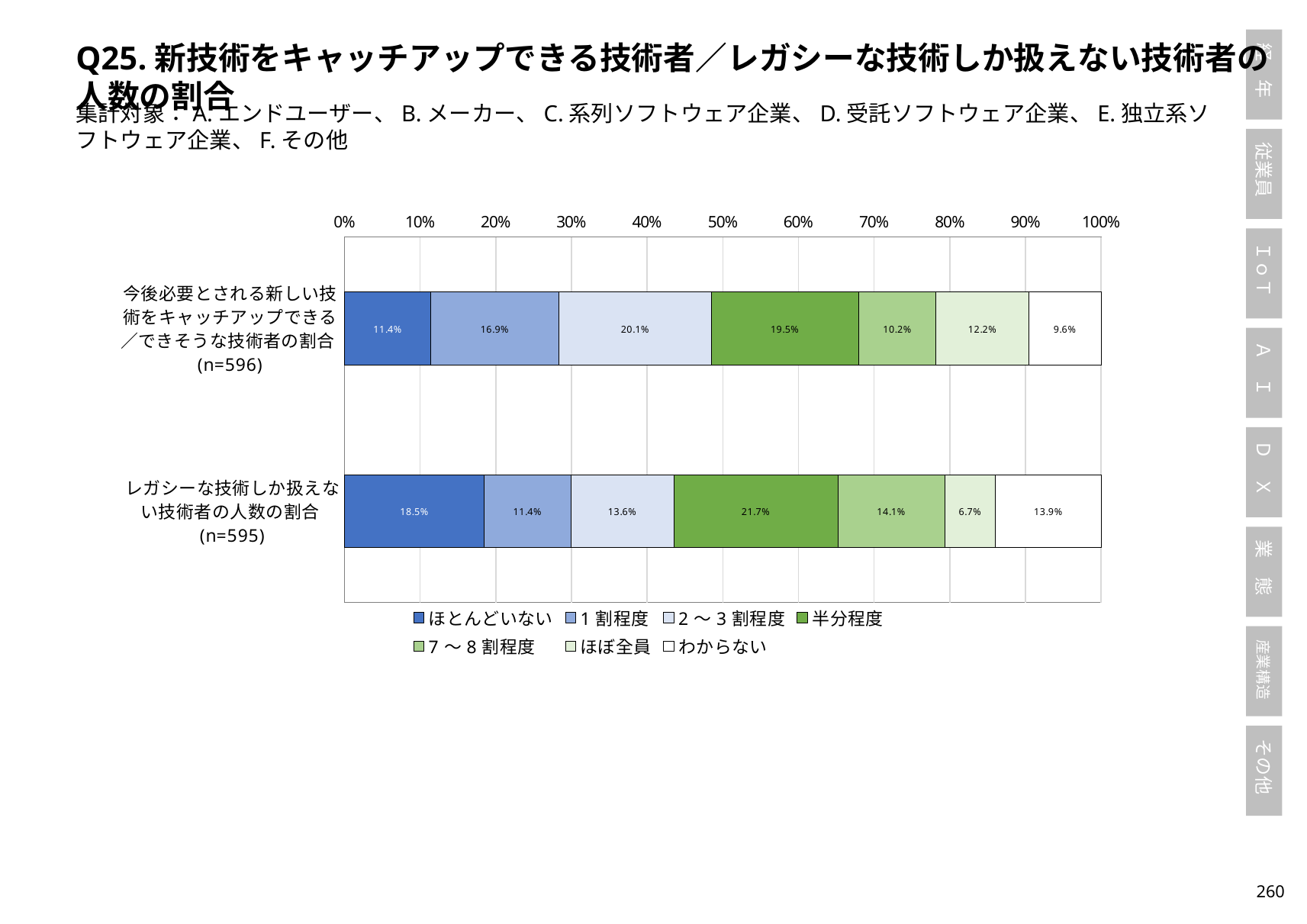
What is the value of 「ほとんどいない」 for 「レガシーな技術しか扱えない技術者の人数の割合」? 18.5% How many series does the legend list? 7 What is the difference between the 「ほとんどいない」 values of the two bars? 7.1% What is the value of 「半分程度」 for 「今後必要とされる新しい技術をキャッチアップできる／できそうな技術者の割合」? 19.5% What kind of chart is shown on the slide? Stacked bar chart Which bar has the larger value for 「ほぼ全員」? 今後必要とされる新しい技術をキャッチアップできる／できそうな技術者の割合 Which segment is the largest in the bar for 「レガシーな技術しか扱えない技術者の人数の割合」? 半分程度 How many categories (bars) are plotted in the chart? 2 Which segment is the smallest in the bar for 「レガシーな技術しか扱えない技術者の人数の割合」? ほぼ全員 What is the value of 「わからない」 for 「レガシーな技術しか扱えない技術者の人数の割合」? 13.9% What is the sample size (n) shown for 「レガシーな技術しか扱えない技術者の人数の割合」? 595 What is the value of 「2～3割程度」 for 「今後必要とされる新しい技術をキャッチアップできる／できそうな技術者の割合」? 20.1%